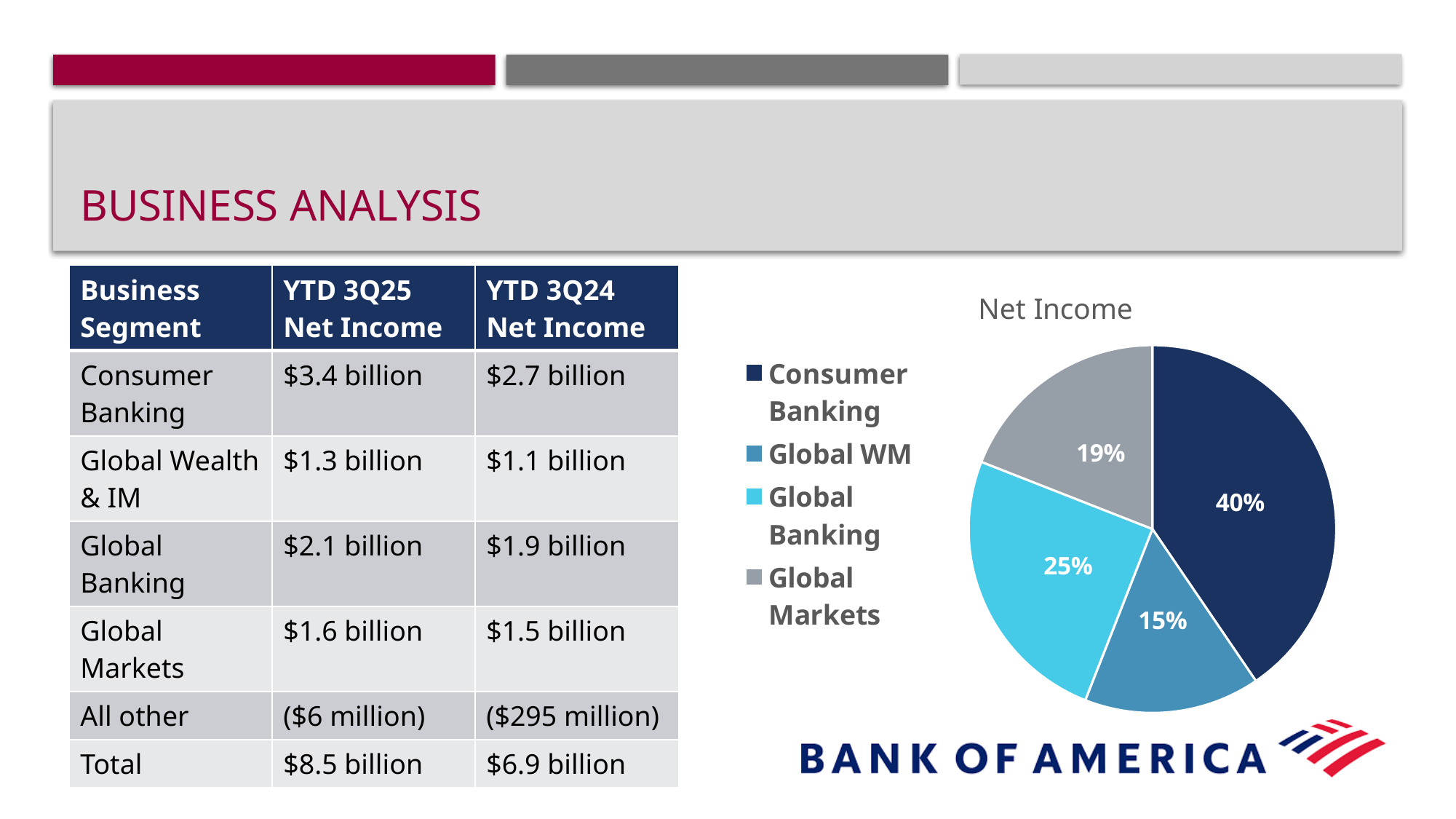
What kind of chart is shown on the slide? pie chart How many slices does the pie chart have? 4 What share of the pie does Global Markets have? 19% What is the title of the chart? Net Income Which segment has the smallest slice of the pie? Global WM Which segment has the largest slice of the pie? Consumer Banking How many entries does the legend list? 4 What share of the pie does Global Banking have? 25% What is the difference in percentage points between the Consumer Banking slice and the Global Banking slice? 15% What share of the pie does Global WM have? 15% Which slice is larger, Global Markets or Global WM? Global Markets